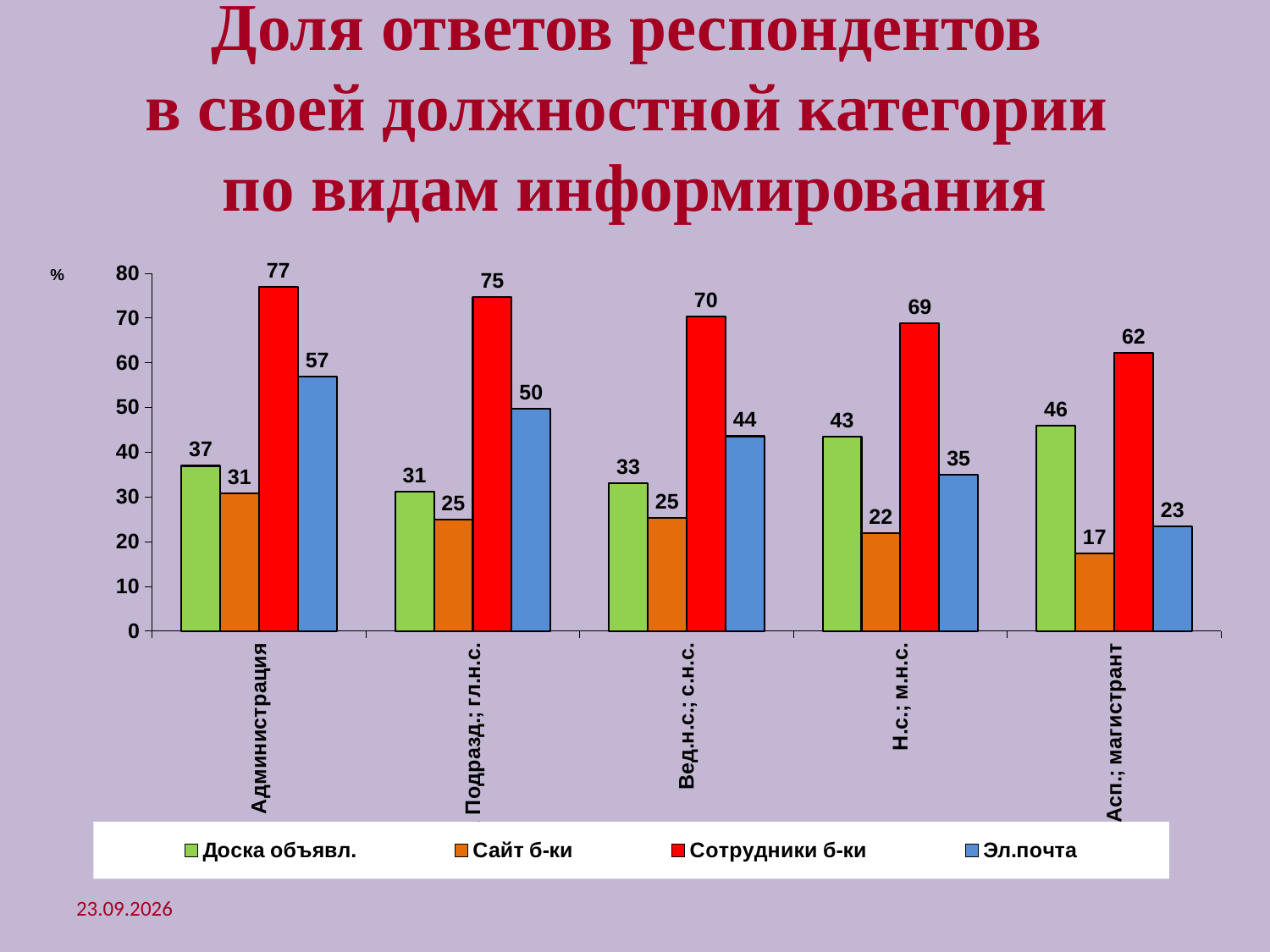
Which is larger in the Вед.н.с.; с.н.с. category: Доска объявл. or Эл.почта? Эл.почта Which category has the lowest value for Сотрудники б-ки? Асп.; магистрант What is the value for Сотрудники б-ки in the Администрация category? 77 How many series does the legend list? 4 Which category has the highest value for Доска объявл.? Асп.; магистрант Which colour represents Сайт б-ки in the chart? orange What kind of chart is shown on the slide? bar chart How many job categories are shown on the x axis? 5 What is the difference between Сотрудники б-ки and Эл.почта in the Подразд.; гл.н.с. category? 25 Is the value for Эл.почта in the Администрация category greater or less than 50? greater What is the value for Сайт б-ки in the Асп.; магистрант category? 17 What is the value for Эл.почта in the Н.с.; м.н.с. category? 35